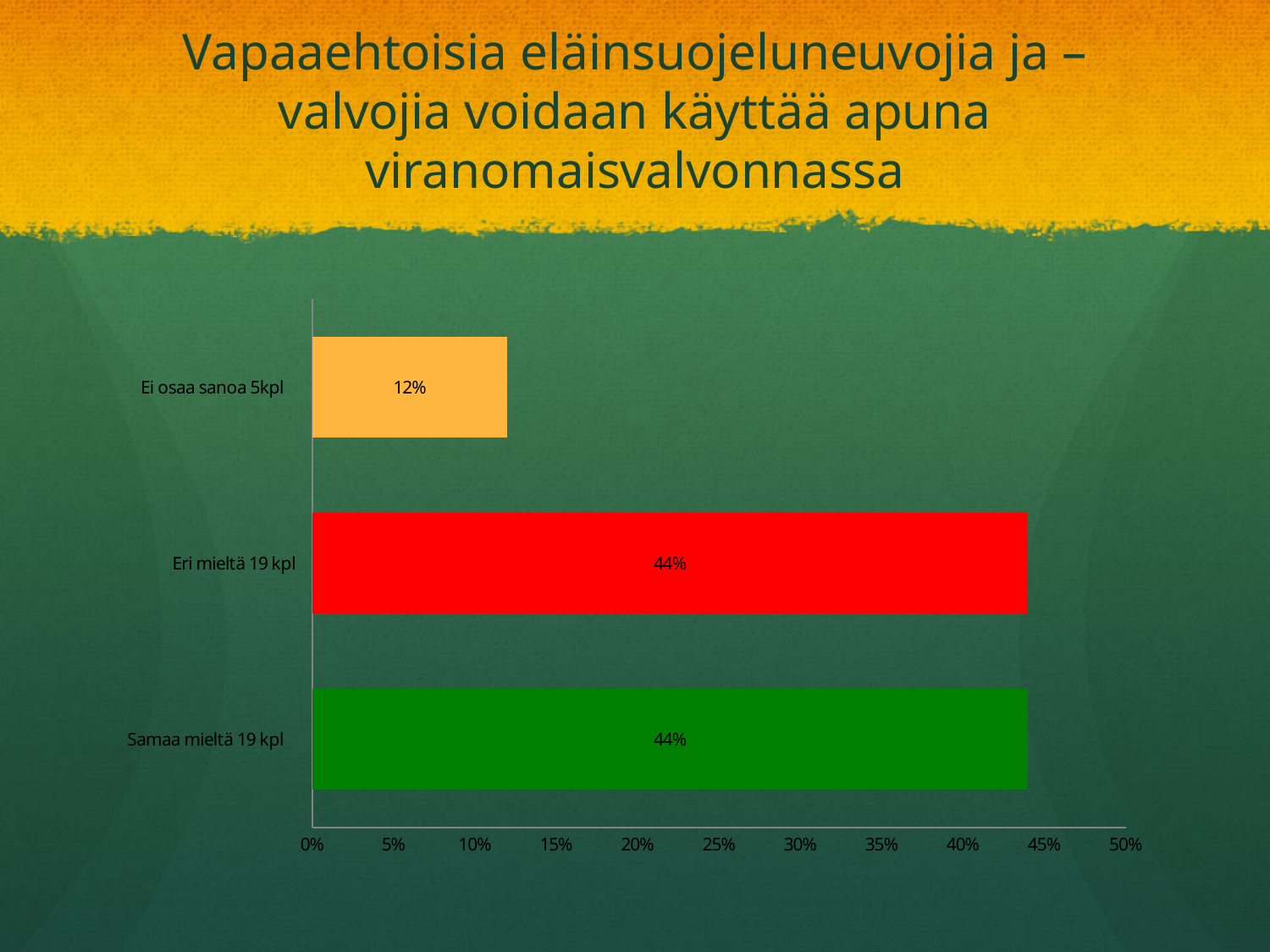
What is the difference between the values for "Eri mieltä 19 kpl" and "Ei osaa sanoa 5kpl"? 32% How many categories are shown in the chart? 3 Which is larger, the value for "Samaa mieltä 19 kpl" or the value for "Ei osaa sanoa 5kpl"? Samaa mieltä 19 kpl What is the value for "Ei osaa sanoa 5kpl"? 12% Is the value for "Ei osaa sanoa 5kpl" greater or less than 15%? less What is the maximum value shown on the x axis? 50% What is the value for "Eri mieltä 19 kpl"? 44% What colour is the bar for "Samaa mieltä 19 kpl"? green Is the value for "Eri mieltä 19 kpl" greater or less than 40%? greater What kind of chart is shown on the slide? bar chart Which category has the lowest value? Ei osaa sanoa 5kpl What is the value for "Samaa mieltä 19 kpl"? 44%